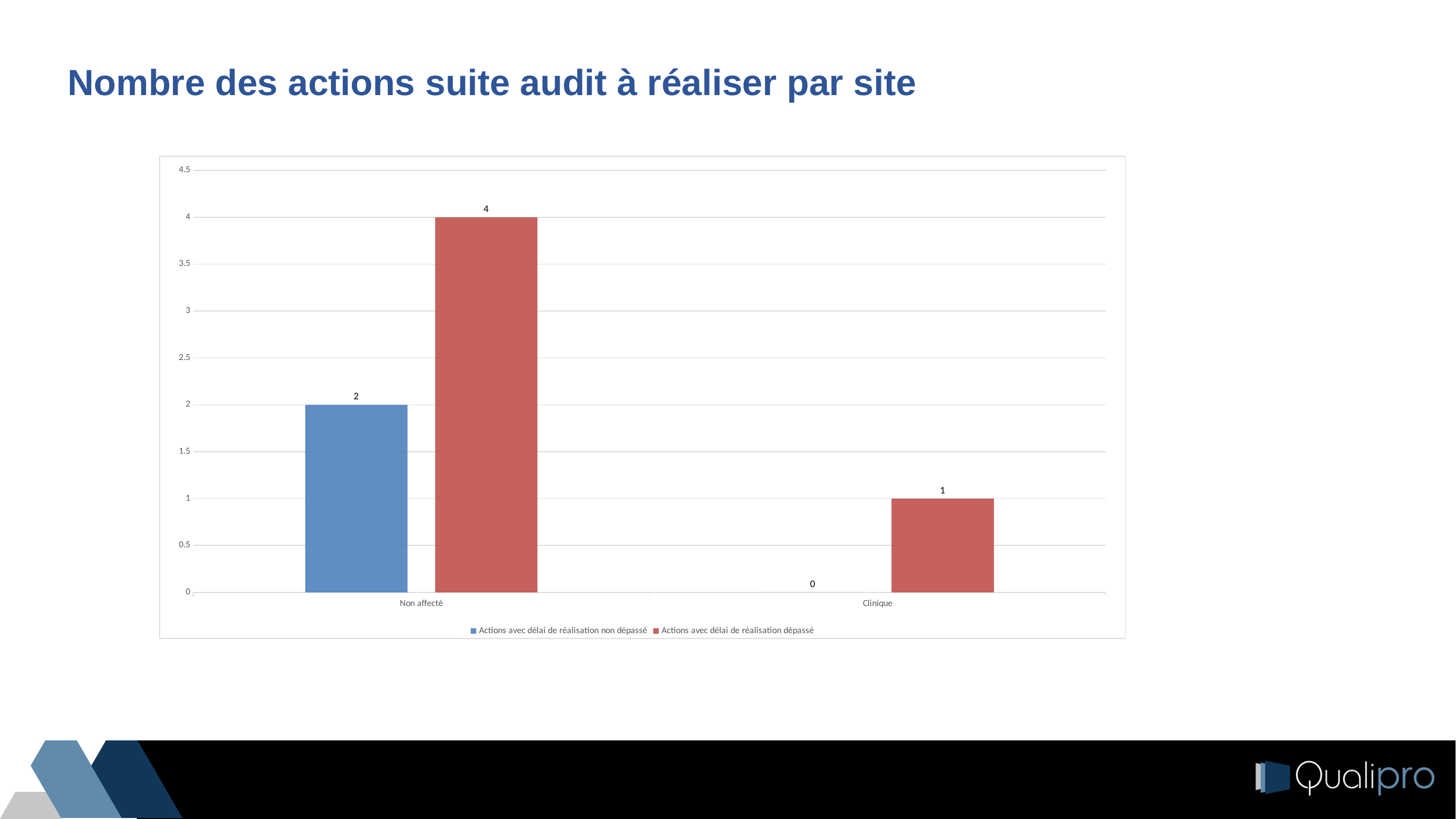
Which site has the lowest value for 'Actions avec délai de réalisation non dépassé'? Clinique What is the value of 'Actions avec délai de réalisation non dépassé' for Non affecté? 2 What kind of chart is shown on the slide? bar chart What is the value of 'Actions avec délai de réalisation dépassé' for Clinique? 1 Which site has the highest value for 'Actions avec délai de réalisation dépassé'? Non affecté How many series does the legend list? 2 What is the value of 'Actions avec délai de réalisation non dépassé' for Clinique? 0 What is the difference between 'Actions avec délai de réalisation dépassé' and 'Actions avec délai de réalisation non dépassé' for Non affecté? 2 Is the value of 'Actions avec délai de réalisation dépassé' for Non affecté greater or less than 3? greater How many sites are shown on the x axis? 2 What is the value of 'Actions avec délai de réalisation dépassé' for Non affecté? 4 Which is larger for Non affecté: 'Actions avec délai de réalisation dépassé' or 'Actions avec délai de réalisation non dépassé'? Actions avec délai de réalisation dépassé